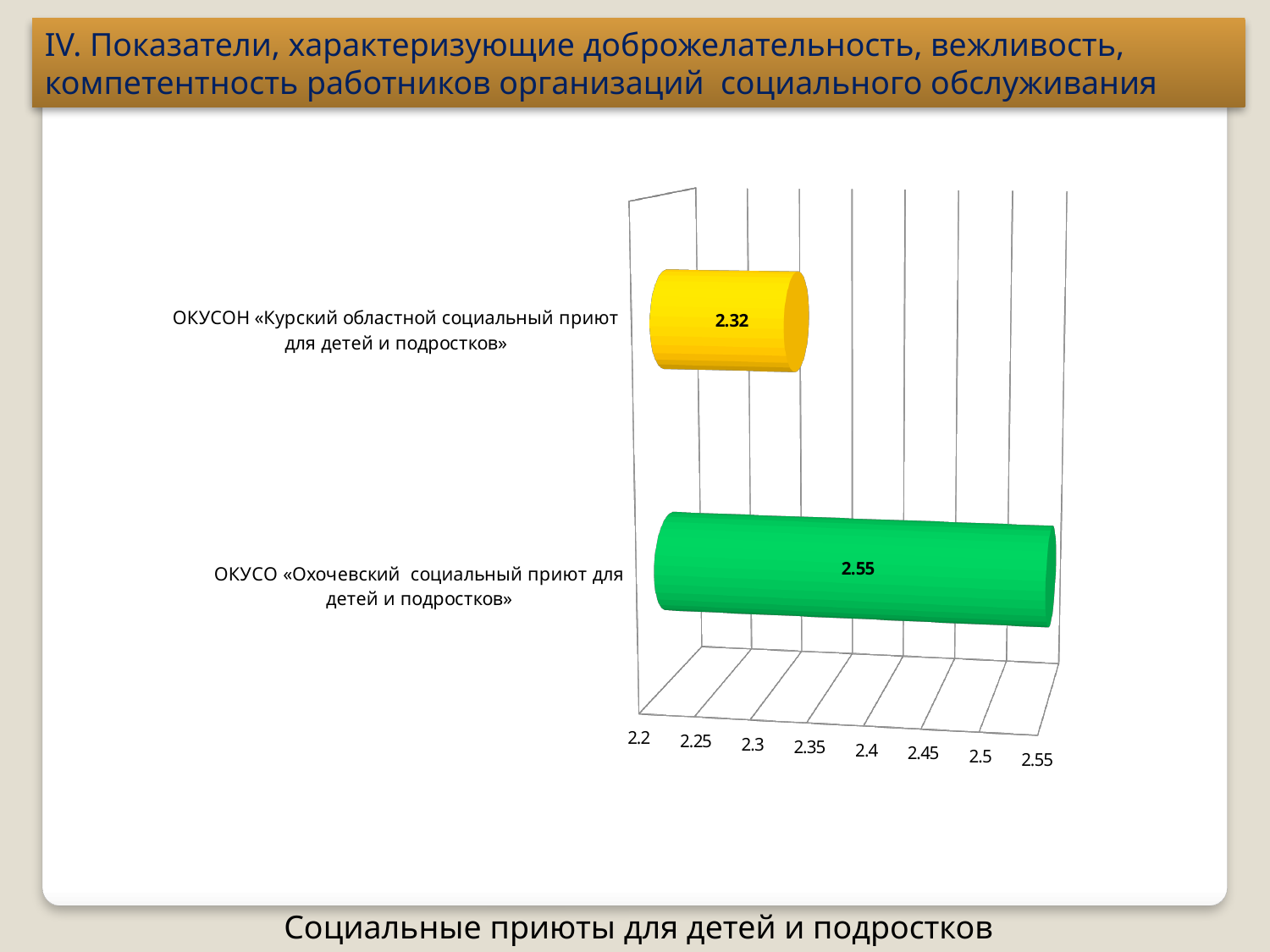
Which organisation has the highest value? ОКУСО «Охочевский социальный приют для детей и подростков» What colour is the bar for ОКУСО «Охочевский социальный приют для детей и подростков»? green What is the lowest value shown on the chart's axis? 2.2 What is the value for ОКУСО «Охочевский социальный приют для детей и подростков»? 2.55 Which organisation has the lowest value? ОКУСОН «Курский областной социальный приют для детей и подростков» What kind of chart is shown on the slide? bar chart What is the difference between the values for ОКУСО «Охочевский социальный приют для детей и подростков» and ОКУСОН «Курский областной социальный приют для детей и подростков»? 0.23 Is the value for ОКУСОН «Курский областной социальный приют для детей и подростков» greater or less than 2.4? less Is the value for ОКУСО «Охочевский социальный приют для детей и подростков» greater or less than 2.5? greater What is the value for ОКУСОН «Курский областной социальный приют для детей и подростков»? 2.32 Which is larger: the value for ОКУСОН «Курский областной социальный приют для детей и подростков» or for ОКУСО «Охочевский социальный приют для детей и подростков»? ОКУСО «Охочевский социальный приют для детей и подростков» How many organisations are shown in the chart? 2